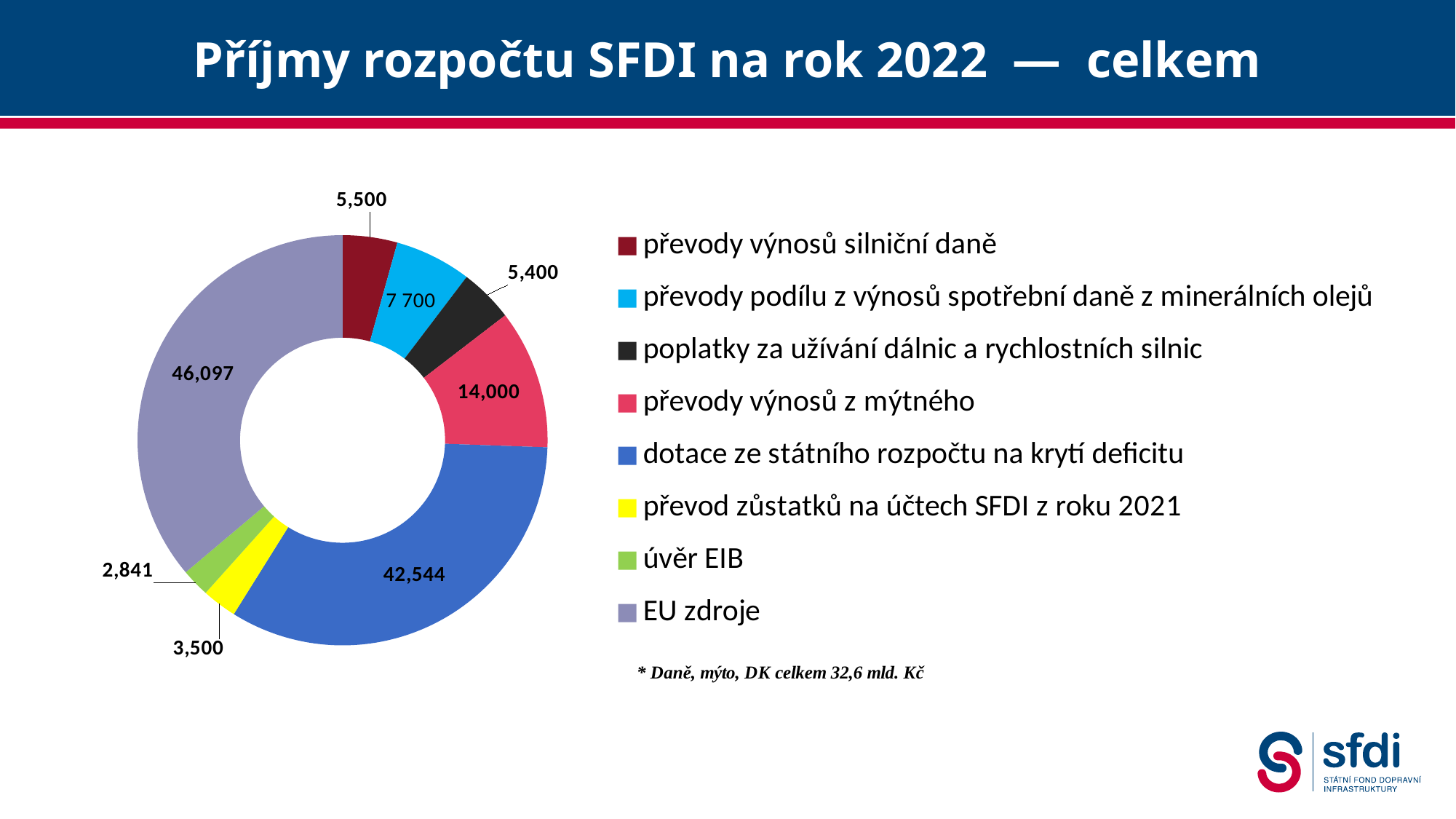
What is the difference between EU zdroje and dotace ze státního rozpočtu na krytí deficitu? 3,553 How many categories does the chart show? 8 What kind of chart is shown on the slide? doughnut chart What is the value for úvěr EIB? 2,841 Which category has the largest slice? EU zdroje What is the value for EU zdroje? 46,097 What colour is the slice for převod zůstatků na účtech SFDI z roku 2021? yellow What is the value for převody podílu z výnosů spotřební daně z minerálních olejů? 7 700 Which category has the smallest slice? úvěr EIB What is the value for dotace ze státního rozpočtu na krytí deficitu? 42,544 Which is larger: převody výnosů z mýtného or převod zůstatků na účtech SFDI z roku 2021? převody výnosů z mýtného What is the value for převody výnosů z mýtného? 14,000